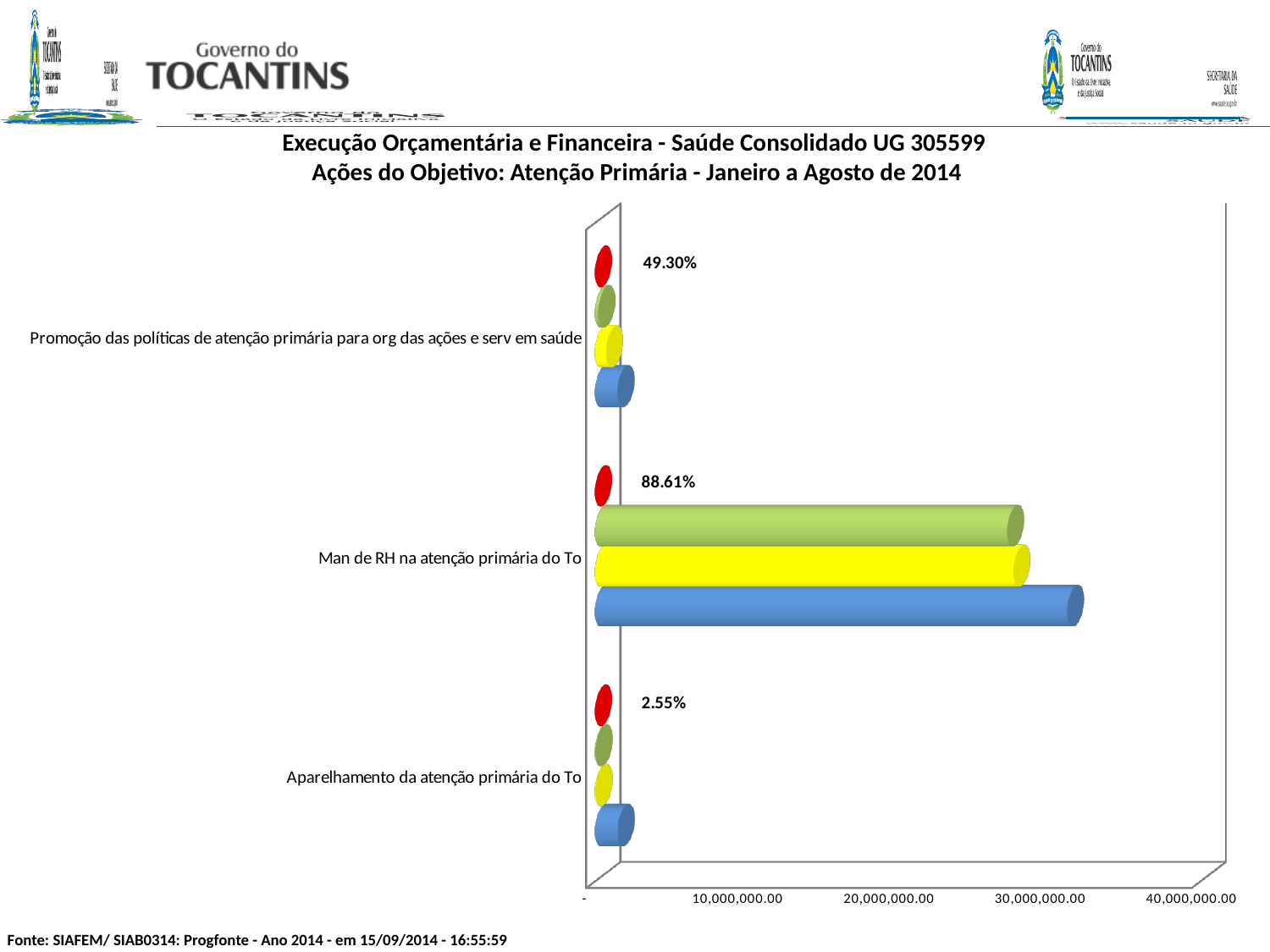
What is the difference between the percentage labels for 'Man de RH na atenção primária do To' and 'Promoção das políticas de atenção primária para org das ações e serv em saúde'? 39.31% What period does the chart title say the data covers? Janeiro a Agosto de 2014 Is the value of the blue bar for 'Man de RH na atenção primária do To' greater or less than 30,000,000.00? greater Which category has the longer blue bar: 'Man de RH na atenção primária do To' or 'Promoção das políticas de atenção primária para org das ações e serv em saúde'? Man de RH na atenção primária do To What percentage is shown for 'Promoção das políticas de atenção primária para org das ações e serv em saúde'? 49.30% How many categories are shown on the chart? 3 Which category has the lowest percentage label? Aparelhamento da atenção primária do To Which category has the highest percentage label? Man de RH na atenção primária do To Is the value of the blue bar for 'Aparelhamento da atenção primária do To' greater or less than 10,000,000.00? less What percentage is shown for 'Man de RH na atenção primária do To'? 88.61% What kind of chart is shown on the slide? Bar chart What percentage is shown for 'Aparelhamento da atenção primária do To'? 2.55%